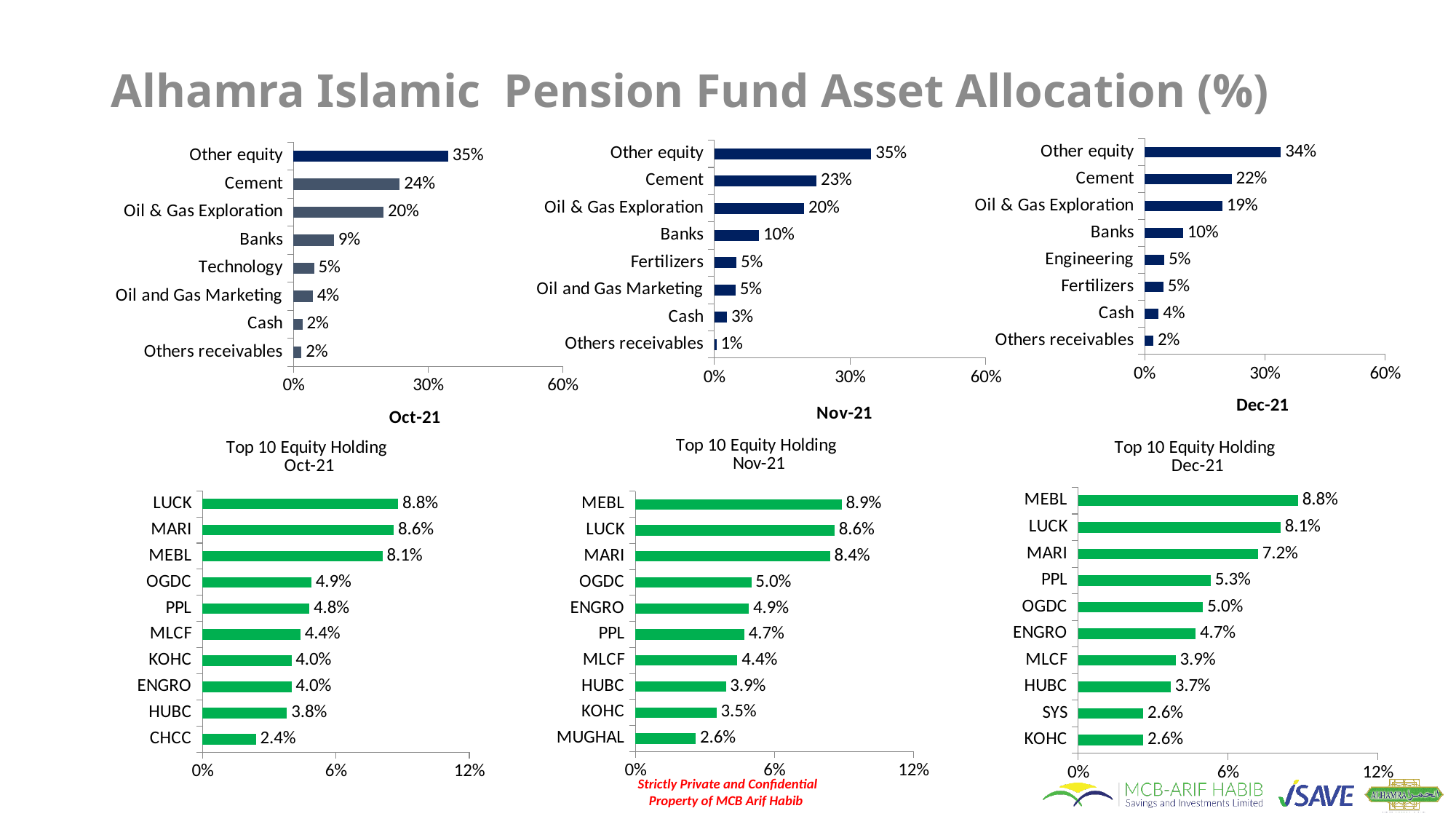
In the Nov-21 asset allocation chart, what is the value for Banks? 10% In the Nov-21 asset allocation chart, which category has the lowest value? Others receivables How many categories are shown in the Oct-21 asset allocation chart? 8 In the Dec-21 asset allocation chart, what is the difference between Other equity and Cement? 12% In the Oct-21 asset allocation chart, what is the value for Cement? 24% In the Top 10 Equity Holding Dec-21 chart, which is larger, LUCK or MARI? LUCK What type of chart is the Top 10 Equity Holding Oct-21 chart? Bar chart In the Top 10 Equity Holding Nov-21 chart, which holding has the highest value? MEBL In the Top 10 Equity Holding Nov-21 chart, what is the difference between MEBL and MUGHAL? 6.3% In the Dec-21 asset allocation chart, which category has the highest value? Other equity In the Top 10 Equity Holding Dec-21 chart, what is the value for PPL? 5.3% In the Top 10 Equity Holding Oct-21 chart, what is the value for MEBL? 8.1%